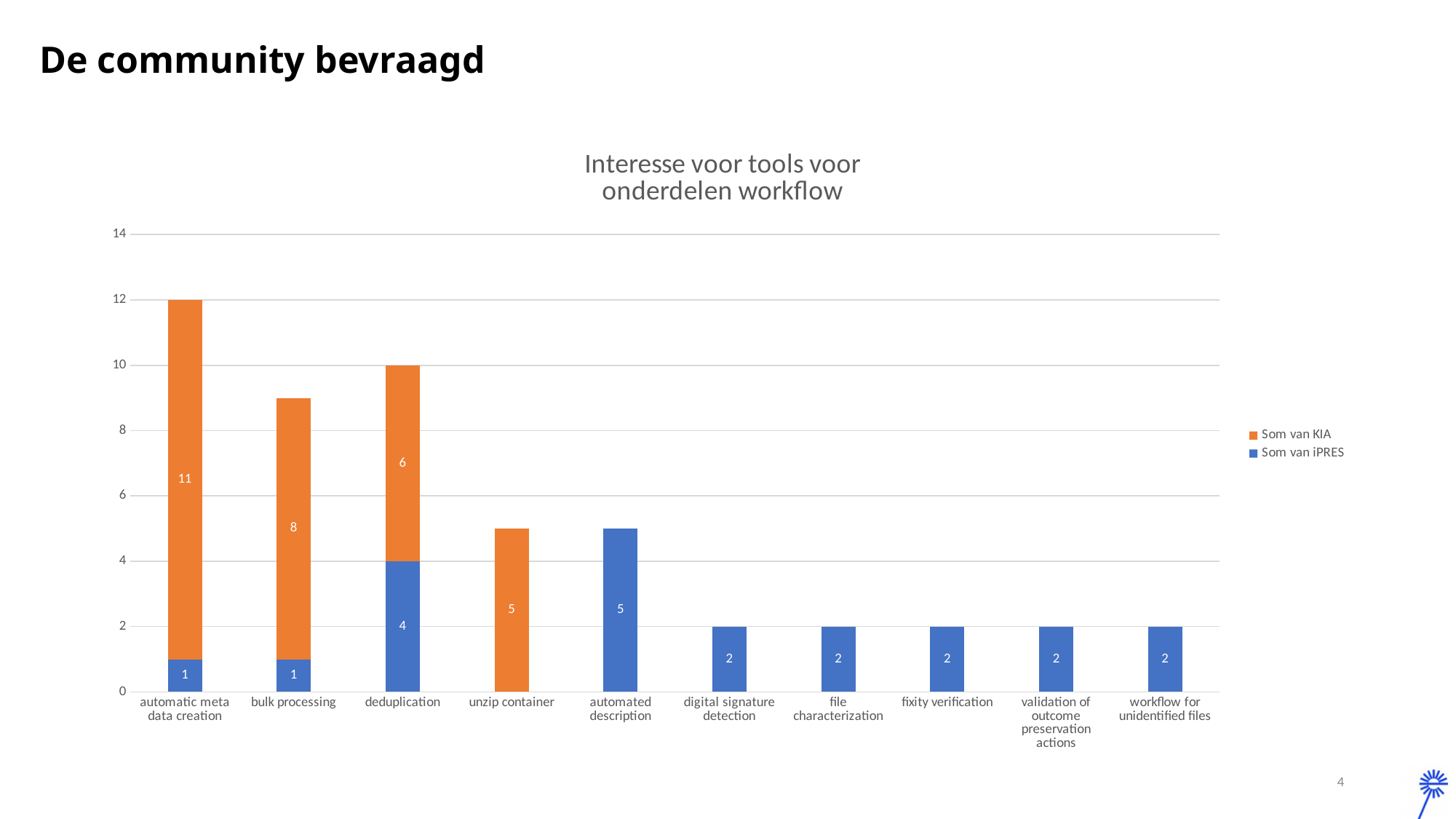
How many categories are shown on the x axis? 10 What is the total of the stacked bar for automatic meta data creation? 12 What is the total of the stacked bar for deduplication? 10 What is the difference between the Som van KIA values for bulk processing and deduplication? 2 How many series does the legend list? 2 What is the Som van KIA value for automatic meta data creation? 11 What is the title of the chart? Interesse voor tools voor onderdelen workflow Which category has the highest Som van KIA value? automatic meta data creation Which is larger: the Som van iPRES value for automated description or for fixity verification? automated description What type of chart is shown on the slide? Stacked bar chart What is the Som van iPRES value for deduplication? 4 What is the Som van KIA value for unzip container? 5